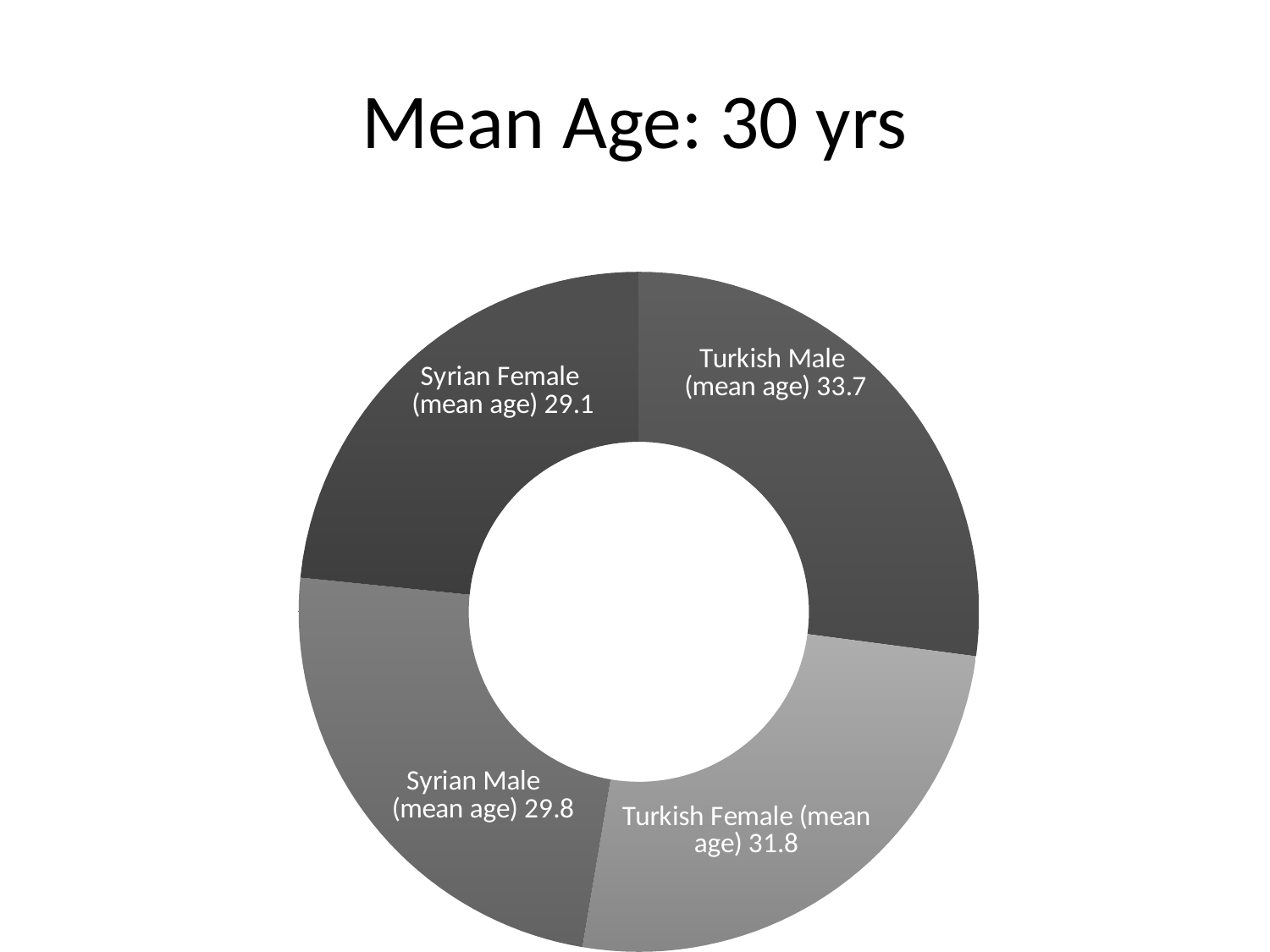
What is the title of the slide? Mean Age: 30 yrs Which group has the lowest mean age shown on the chart? Syrian Female Which group has the highest mean age shown on the chart? Turkish Male What kind of chart is shown on the slide? Doughnut (pie) chart What is the mean age shown for Syrian Male? 29.8 What is the mean age shown for Syrian Female? 29.1 What is the difference between the mean age of Turkish Female and Syrian Male? 2.0 What is the mean age shown for Turkish Female? 31.8 What is the difference between the mean age of Turkish Male and Syrian Female? 4.6 How many groups are shown on the chart? 4 Which has a higher mean age, Turkish Female or Syrian Male? Turkish Female What is the mean age shown for Turkish Male? 33.7